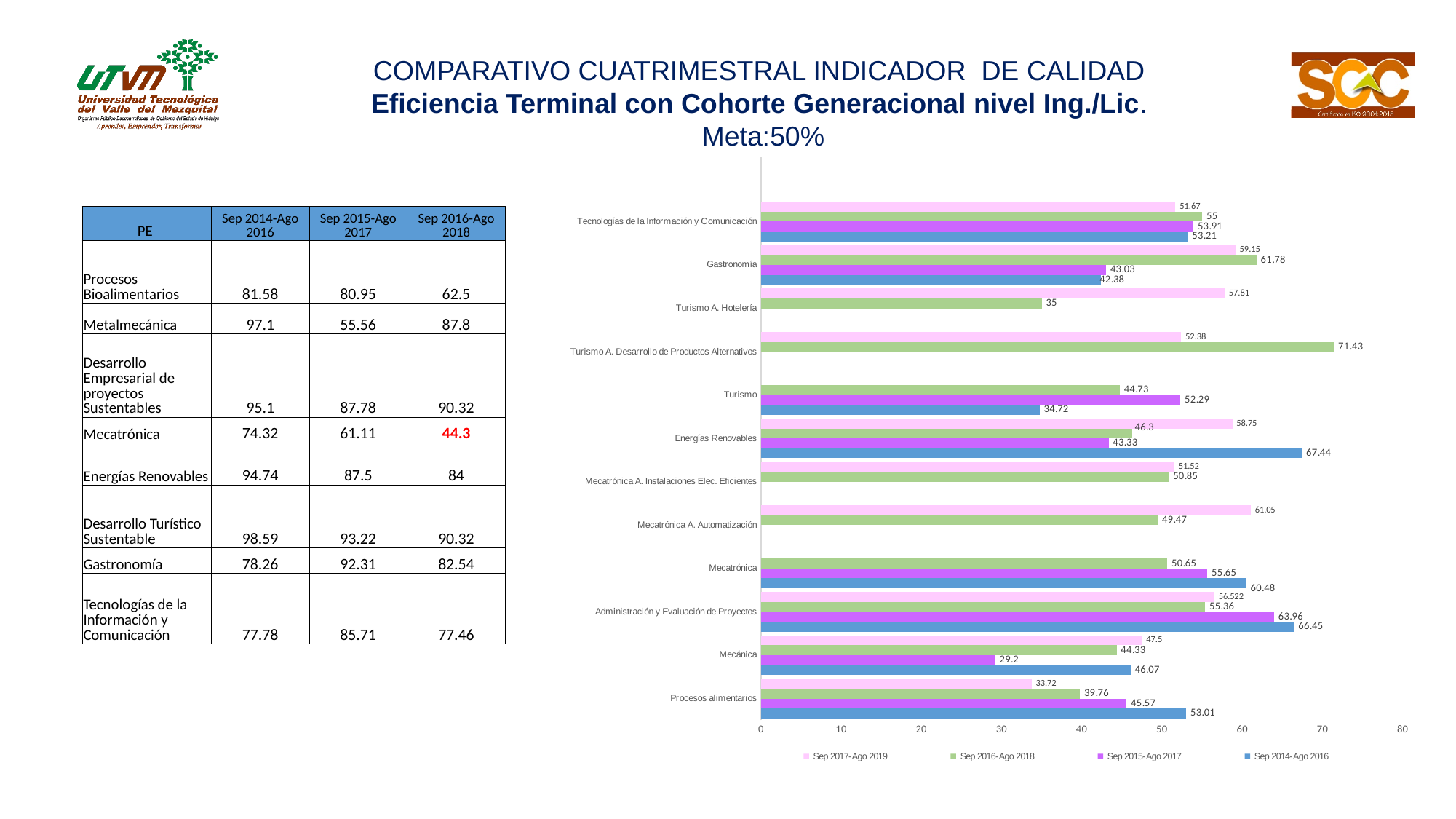
What kind of chart is shown on the slide? bar chart What is the Sep 2016-Ago 2018 value for Turismo A. Desarrollo de Productos Alternativos? 71.43 Which category has the highest Sep 2016-Ago 2018 value? Turismo A. Desarrollo de Productos Alternativos Which series is shown in pink in the chart legend? Sep 2017-Ago 2019 What is the Sep 2017-Ago 2019 value for Procesos alimentarios? 33.72 For Gastronomía, which is larger: the Sep 2016-Ago 2018 value or the Sep 2017-Ago 2019 value? Sep 2016-Ago 2018 How many categories (programs) are plotted on the chart? 12 What is the difference between the Sep 2014-Ago 2016 and Sep 2015-Ago 2017 values for Administración y Evaluación de Proyectos? 2.49 How many series does the chart legend list? 4 Is the Sep 2016-Ago 2018 value for Turismo A. Hotelería greater or less than 40? less What is the Sep 2014-Ago 2016 value for Energías Renovables? 67.44 Which category has the lowest Sep 2015-Ago 2017 value? Mecánica